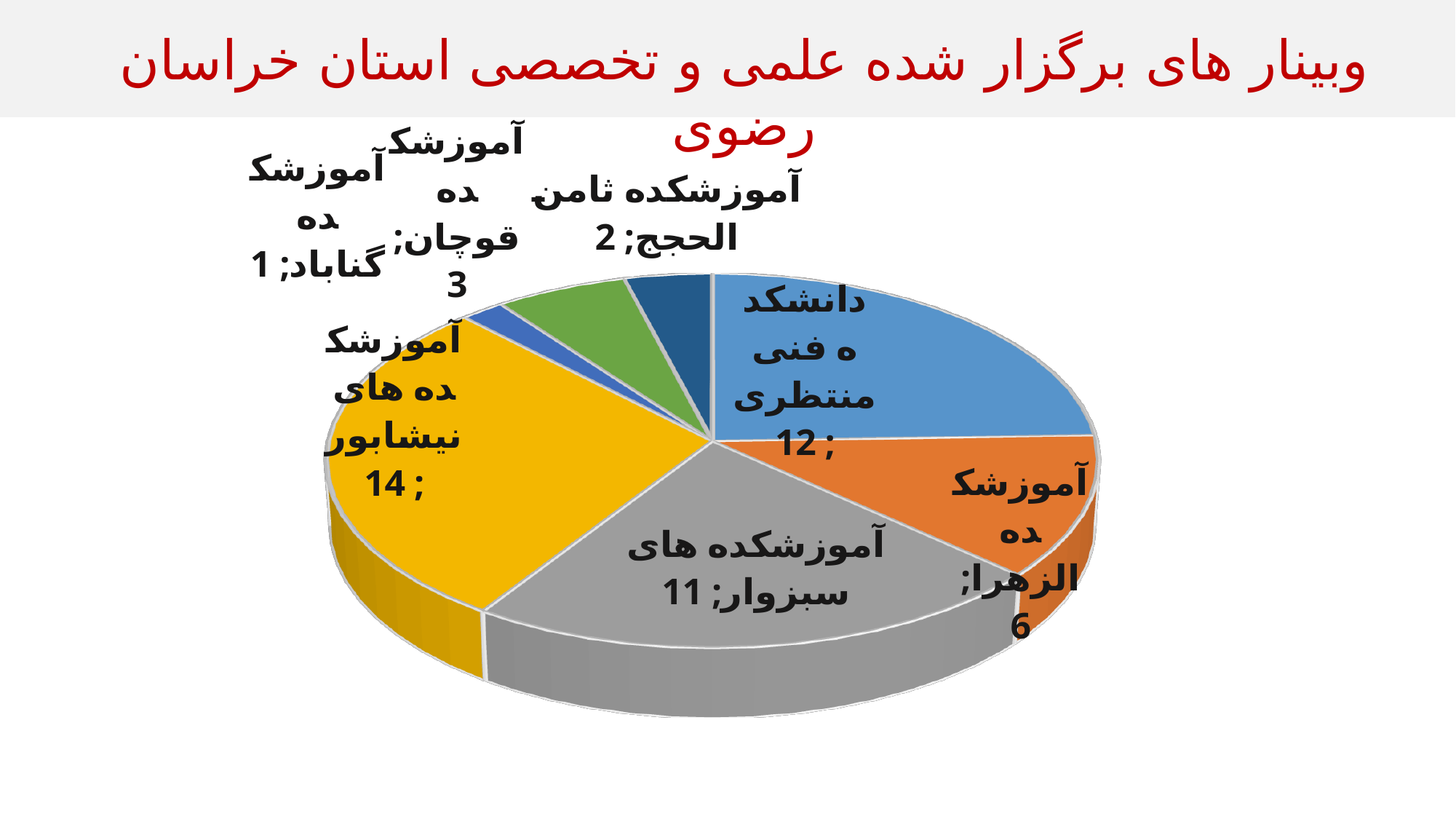
Which is larger, the value for دانشکده فنی منتظری or the value for آموزشکده های سبزوار? دانشکده فنی منتظری Which category has the smallest slice of the pie? آموزشکده گناباد What is the value for دانشکده فنی منتظری? 12 What is the total of all the values shown in the pie chart? 49 How many slices does the pie chart have? 7 What is the value for آموزشکده های نیشابور? 14 What is the difference between the values for آموزشکده های نیشابور and آموزشکده الزهرا? 8 What is the value for آموزشکده قوچان? 3 Which category has the largest slice of the pie? آموزشکده های نیشابور What type of chart is shown on the slide? pie chart What is the value for آموزشکده الزهرا? 6 What is the value for آموزشکده های سبزوار? 11